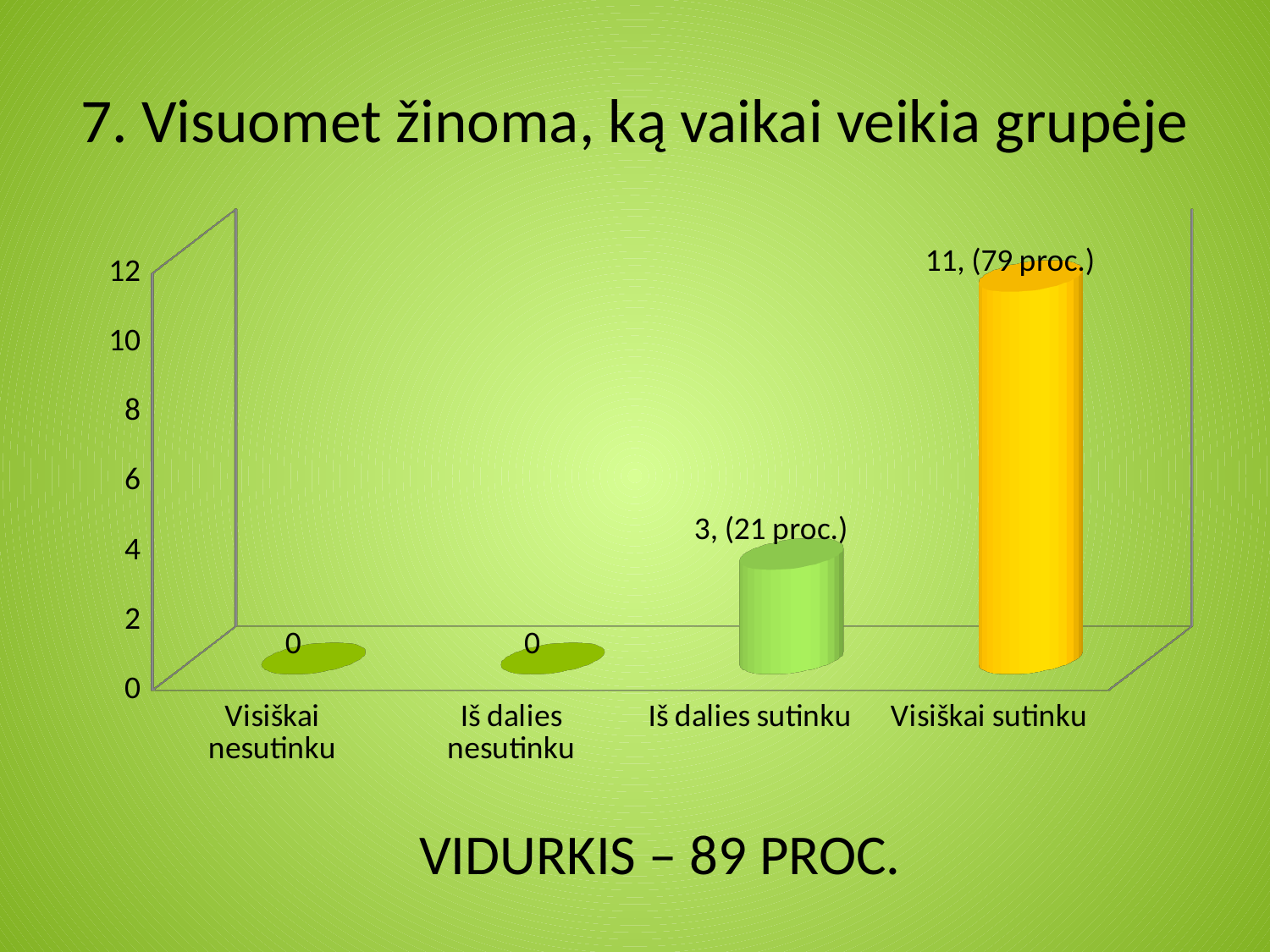
What is the value for Visiškai sutinku? 11, (79 proc.) What is the value for Iš dalies sutinku? 3, (21 proc.) Is the value for Iš dalies sutinku greater or less than 4? less Which is larger, the value for Iš dalies sutinku or the value for Visiškai sutinku? Visiškai sutinku What kind of chart is shown on the slide? bar chart What is the value for Iš dalies nesutinku? 0 What is the difference in count between Visiškai sutinku and Iš dalies sutinku? 8 What is the value for Visiškai nesutinku? 0 What is the title of the chart on the slide? 7. Visuomet žinoma, ką vaikai veikia grupėje Is the value for Visiškai sutinku greater or less than 10? greater How many categories are shown on the x axis? 4 Which category has the highest value? Visiškai sutinku